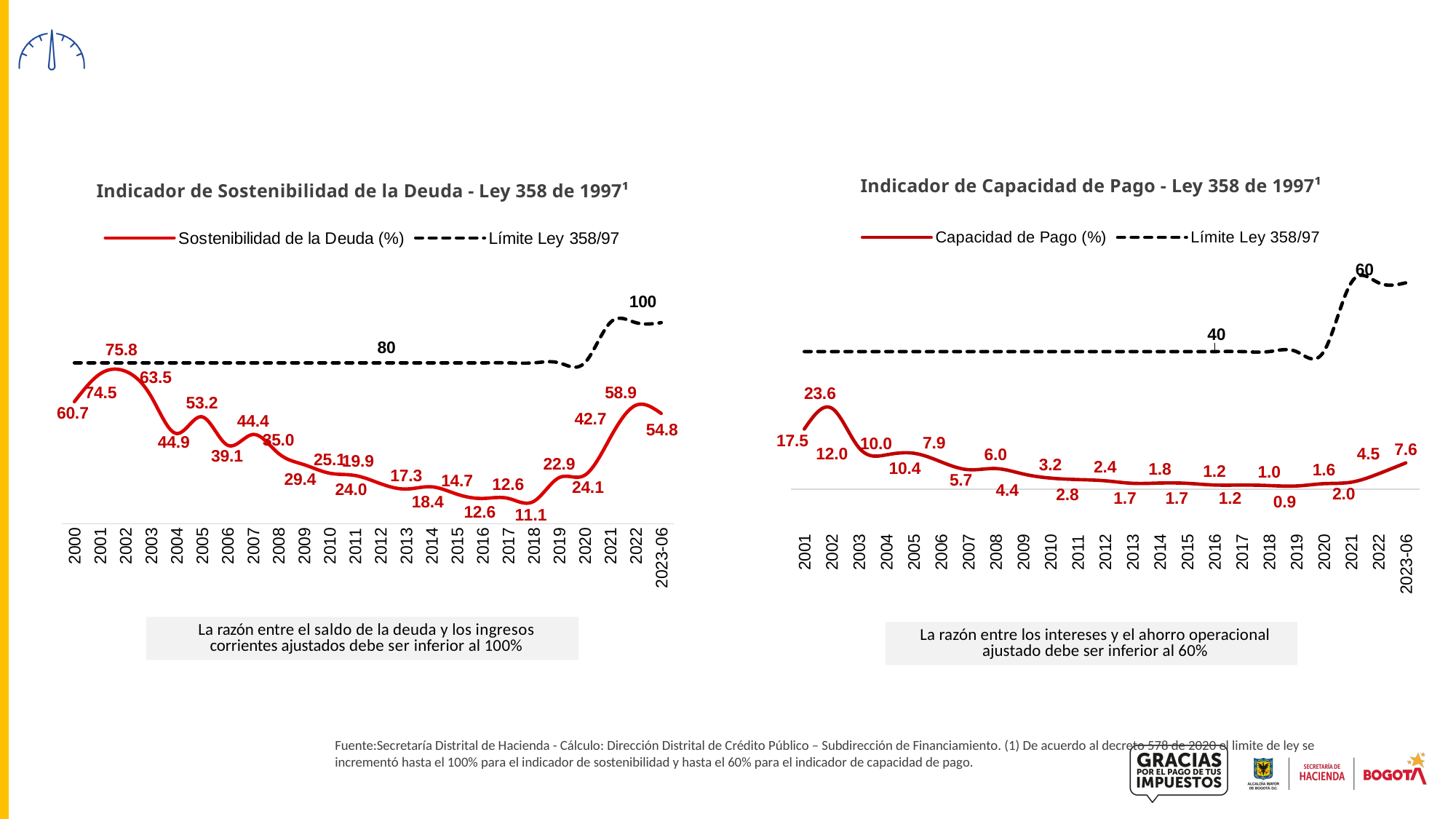
In the chart titled 'Indicador de Sostenibilidad de la Deuda - Ley 358 de 1997', what is the difference between the 2022 value (58.9) and the 2023-06 value (54.8)? 4.1 In the chart titled 'Indicador de Sostenibilidad de la Deuda - Ley 358 de 1997', how many series does the legend list? 2 In the chart titled 'Indicador de Capacidad de Pago - Ley 358 de 1997', what is the highest value of the Capacidad de Pago (%) series? 23.6 In the chart titled 'Indicador de Capacidad de Pago - Ley 358 de 1997', what is the value of Capacidad de Pago (%) for 2023-06? 7.6 In the chart titled 'Indicador de Sostenibilidad de la Deuda - Ley 358 de 1997', what is the highest value of the Sostenibilidad de la Deuda (%) series? 75.8 In the chart titled 'Indicador de Sostenibilidad de la Deuda - Ley 358 de 1997', what is the lowest value of the Sostenibilidad de la Deuda (%) series? 11.1 In the chart titled 'Indicador de Sostenibilidad de la Deuda - Ley 358 de 1997', what is the value of Sostenibilidad de la Deuda (%) for 2000? 60.7 In the chart titled 'Indicador de Sostenibilidad de la Deuda - Ley 358 de 1997', what is the value of Sostenibilidad de la Deuda (%) for 2023-06? 54.8 In the chart titled 'Indicador de Capacidad de Pago - Ley 358 de 1997', what kind of chart is it? Line chart In the chart titled 'Indicador de Capacidad de Pago - Ley 358 de 1997', what is the lowest value of the Capacidad de Pago (%) series? 0.9 In the chart titled 'Indicador de Capacidad de Pago - Ley 358 de 1997', which is larger: the Capacidad de Pago value for 2001 or for 2002? 2002 In the chart titled 'Indicador de Capacidad de Pago - Ley 358 de 1997', what is the final value of the Límite Ley 358/97 series shown at the right end? 60